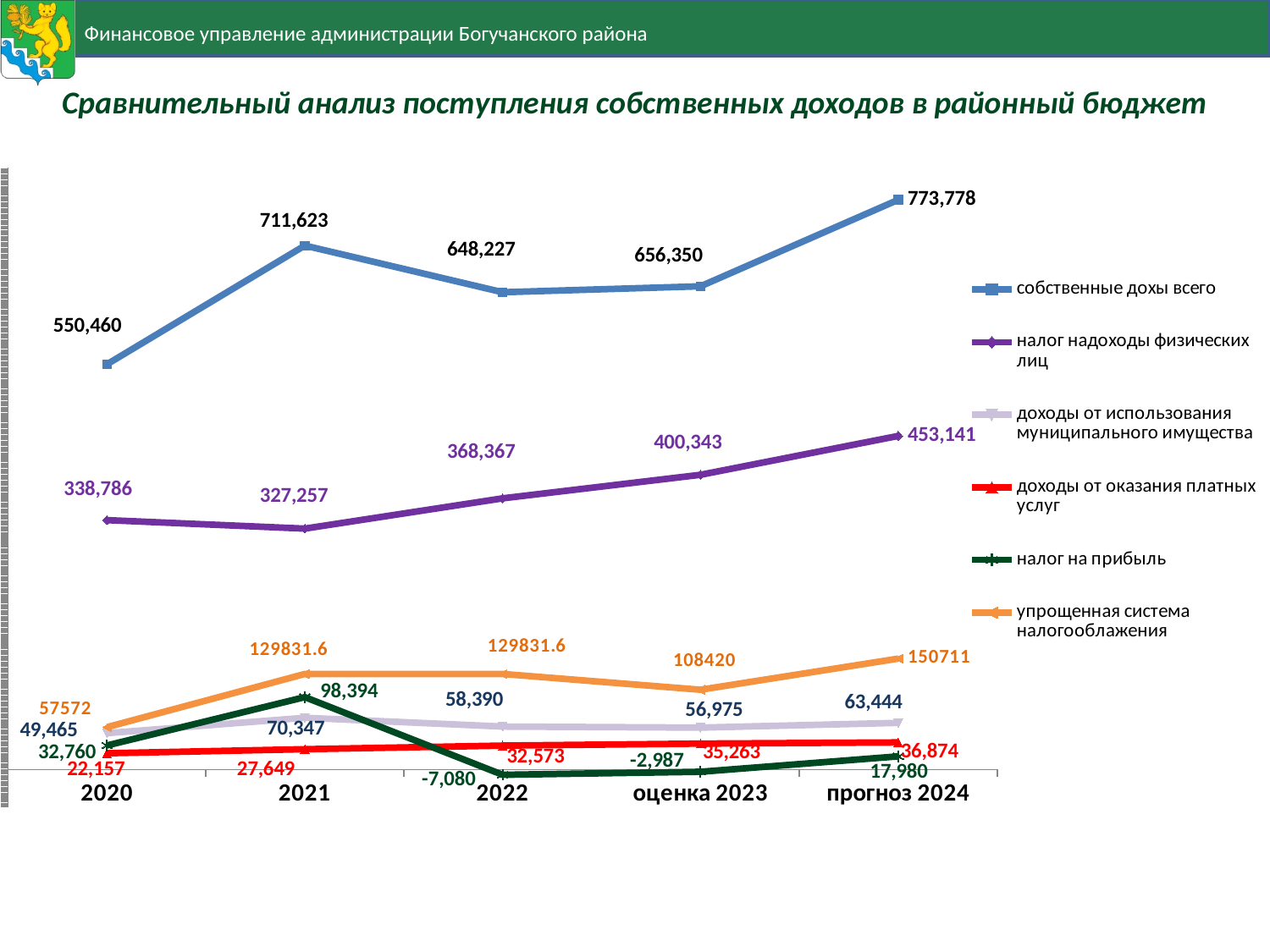
How many series does the legend list? 6 What is the value of 'налог на доходы физических лиц' for прогноз 2024? 453,141 What type of chart is shown on the slide? line chart In which year is 'собственные доходы всего' the lowest? 2020 What is the value of 'упрощенная система налогообложения' for оценка 2023? 108420 What is the value of 'собственные доходы всего' for 2021? 711,623 Which is larger in 2022: 'доходы от использования муниципального имущества' or 'доходы от оказания платных услуг'? доходы от использования муниципального имущества In which year is 'налог на прибыль' the highest? 2021 Does 'доходы от оказания платных услуг' rise or fall from 2020 to прогноз 2024? rise What is the difference between 'собственные доходы всего' in прогноз 2024 and in 2020? 223,318 How many points along the x axis does the chart have? 5 What is the value of 'налог на прибыль' for 2022? -7,080